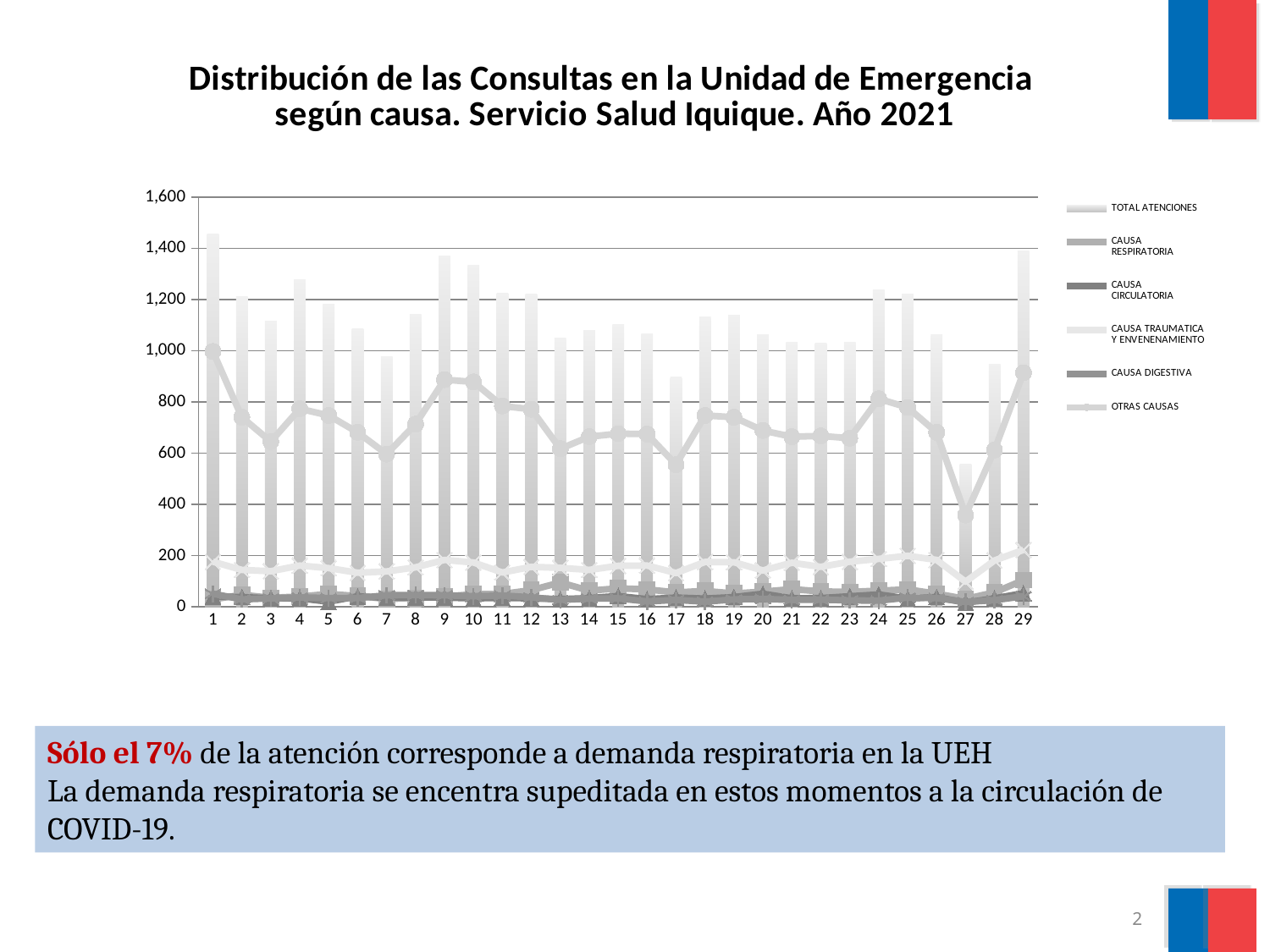
At which x-axis point is the OTRAS CAUSAS line lowest? 27 Does TOTAL ATENCIONES rise or fall from point 27 to point 29? rise Which series is plotted as bars? TOTAL ATENCIONES How many series does the legend list? 6 Is the TOTAL ATENCIONES value at point 1 greater or less than 1,200? greater What kind of chart is shown on the slide? A combination bar and line chart At which x-axis point is TOTAL ATENCIONES lowest? 27 How many points are shown along the x axis? 29 What is the title of the chart? Distribución de las Consultas en la Unidad de Emergencia según causa. Servicio Salud Iquique. Año 2021 Which has the larger TOTAL ATENCIONES value, point 9 or point 7? 9 Is the OTRAS CAUSAS value at point 1 greater or less than 800? greater Is the TOTAL ATENCIONES value at point 27 greater or less than 800? less